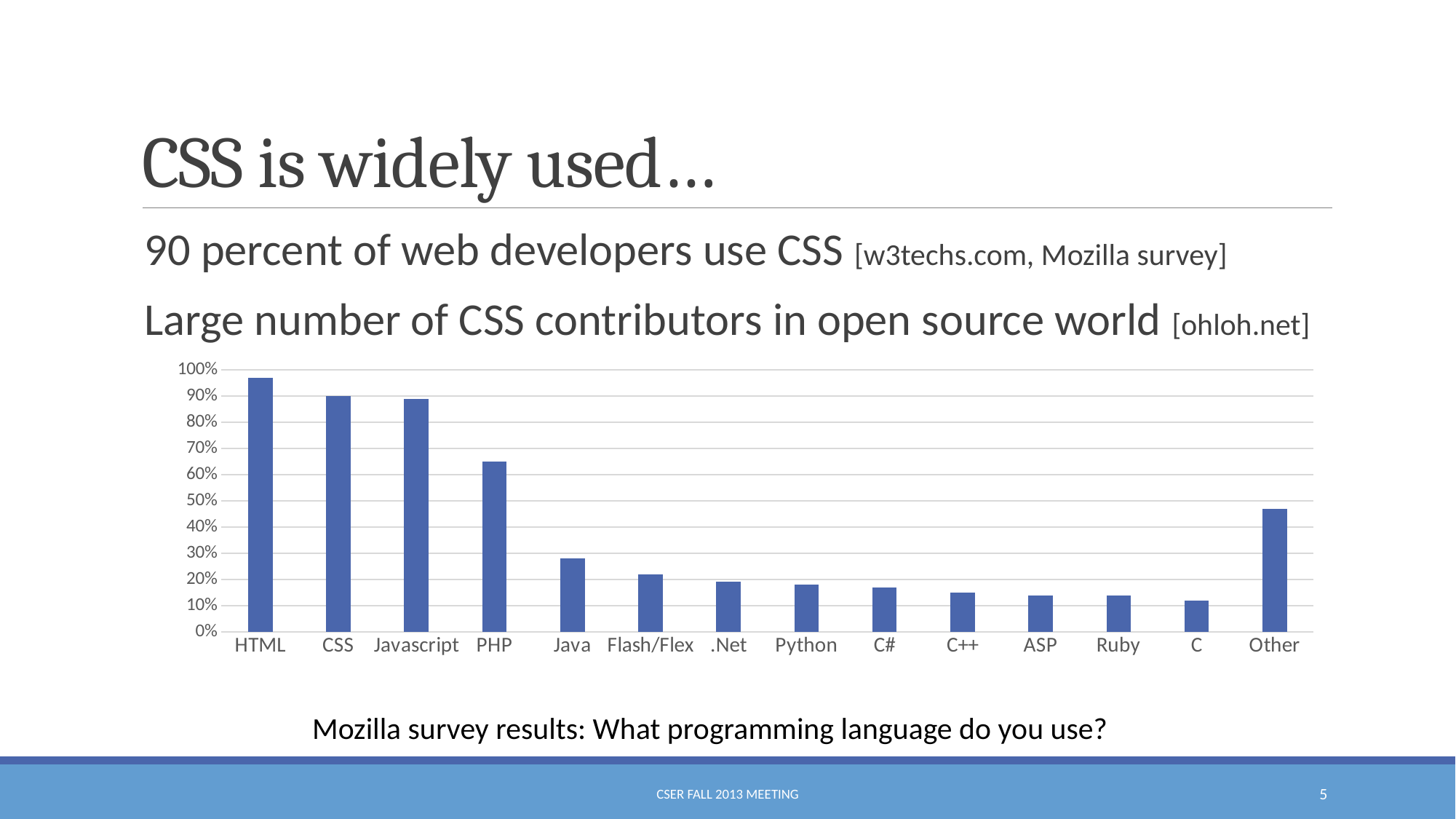
Which category has the highest bar in the chart? HTML Is the value for Java greater or less than 30%? less How many programming language categories are shown on the x axis of the chart? 14 Is the value for Other greater or less than 50%? less Is the value for PHP greater or less than 60%? greater According to the caption below the chart, what survey question do the results answer? What programming language do you use? What is the value for CSS in the chart? 90% Which category has the lowest bar in the chart? C Which is larger, the value for PHP or the value for Other? PHP What kind of chart is shown on the slide? bar chart Which is larger, the value for Java or the value for Python? Java